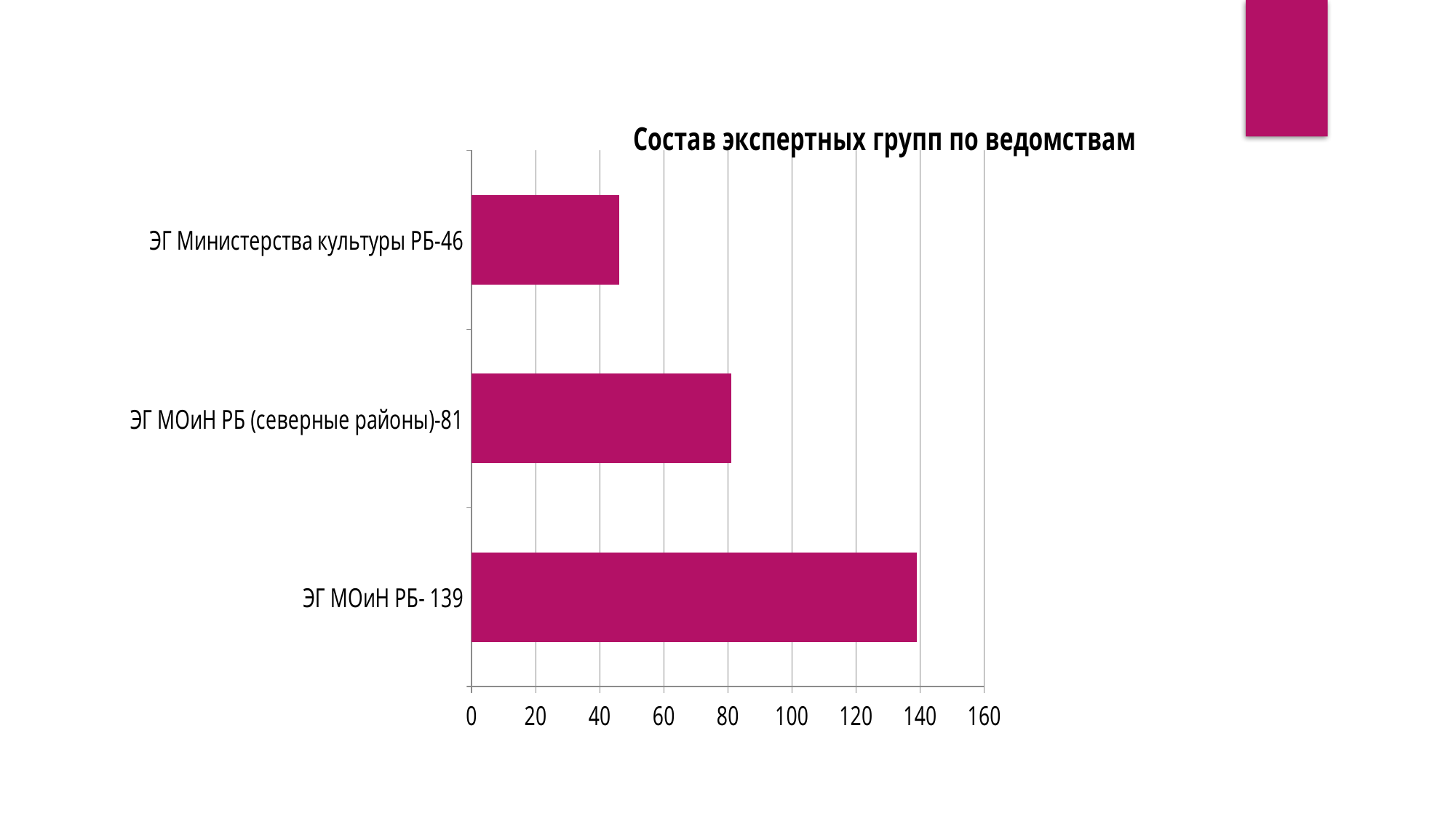
How many categories are shown in the chart? 3 Which category has the highest value? ЭГ МОиН РБ Which category has the lowest value? ЭГ Министерства культуры РБ What is the value for ЭГ МОиН РБ (северные районы)? 81 Is the value for ЭГ МОиН РБ greater or less than 120? greater What is the title of the chart? Состав экспертных групп по ведомствам What is the value for ЭГ Министерства культуры РБ? 46 What type of chart is shown on the slide? bar chart Which is larger, the value for ЭГ МОиН РБ (северные районы) or the value for ЭГ Министерства культуры РБ? ЭГ МОиН РБ (северные районы) What is the difference between the values for ЭГ МОиН РБ (северные районы) and ЭГ Министерства культуры РБ? 35 What is the value for ЭГ МОиН РБ? 139 What is the difference between the values for ЭГ МОиН РБ and ЭГ МОиН РБ (северные районы)? 58